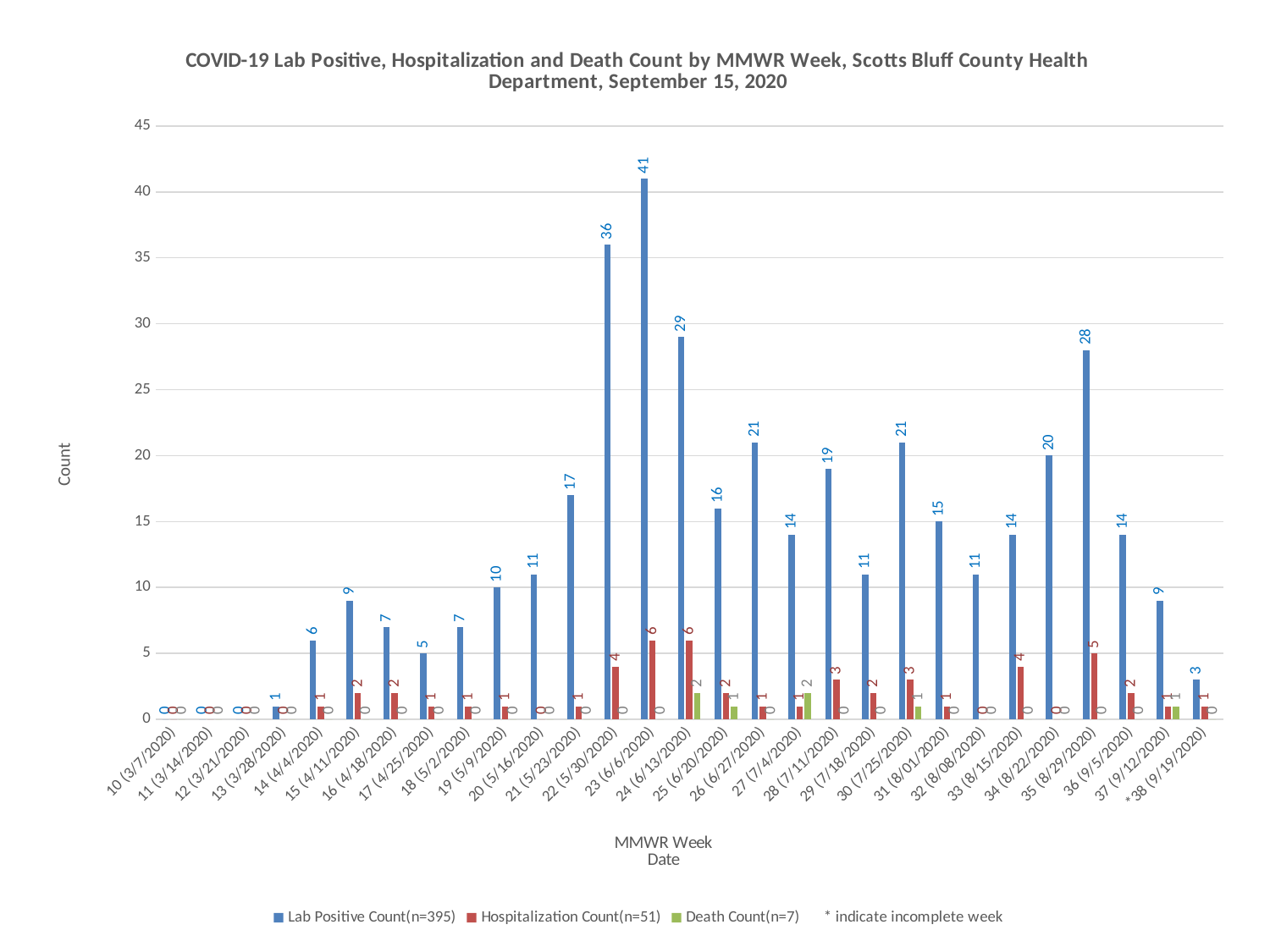
What does the asterisk (*) on week 38 indicate, according to the legend note? Incomplete week What is the Lab Positive Count for MMWR week 23 (6/6/2020)? 41 How many MMWR weeks are shown on the x axis? 29 How many series does the legend list? 3 Which MMWR week has the highest Lab Positive Count? 23 (6/6/2020) What is the Death Count for MMWR week 24 (6/13/2020)? 2 What is the Hospitalization Count for MMWR week 35 (8/29/2020)? 5 What kind of chart is this? Bar chart What is the difference between the Lab Positive Count for week 23 (6/6/2020) and week 22 (5/30/2020)? 5 What is the total n shown in the legend for the Hospitalization Count series? 51 Which is larger, the Lab Positive Count for week 24 (6/13/2020) or for week 35 (8/29/2020)? 24 (6/13/2020) What is the Lab Positive Count for MMWR week 21 (5/23/2020)? 17